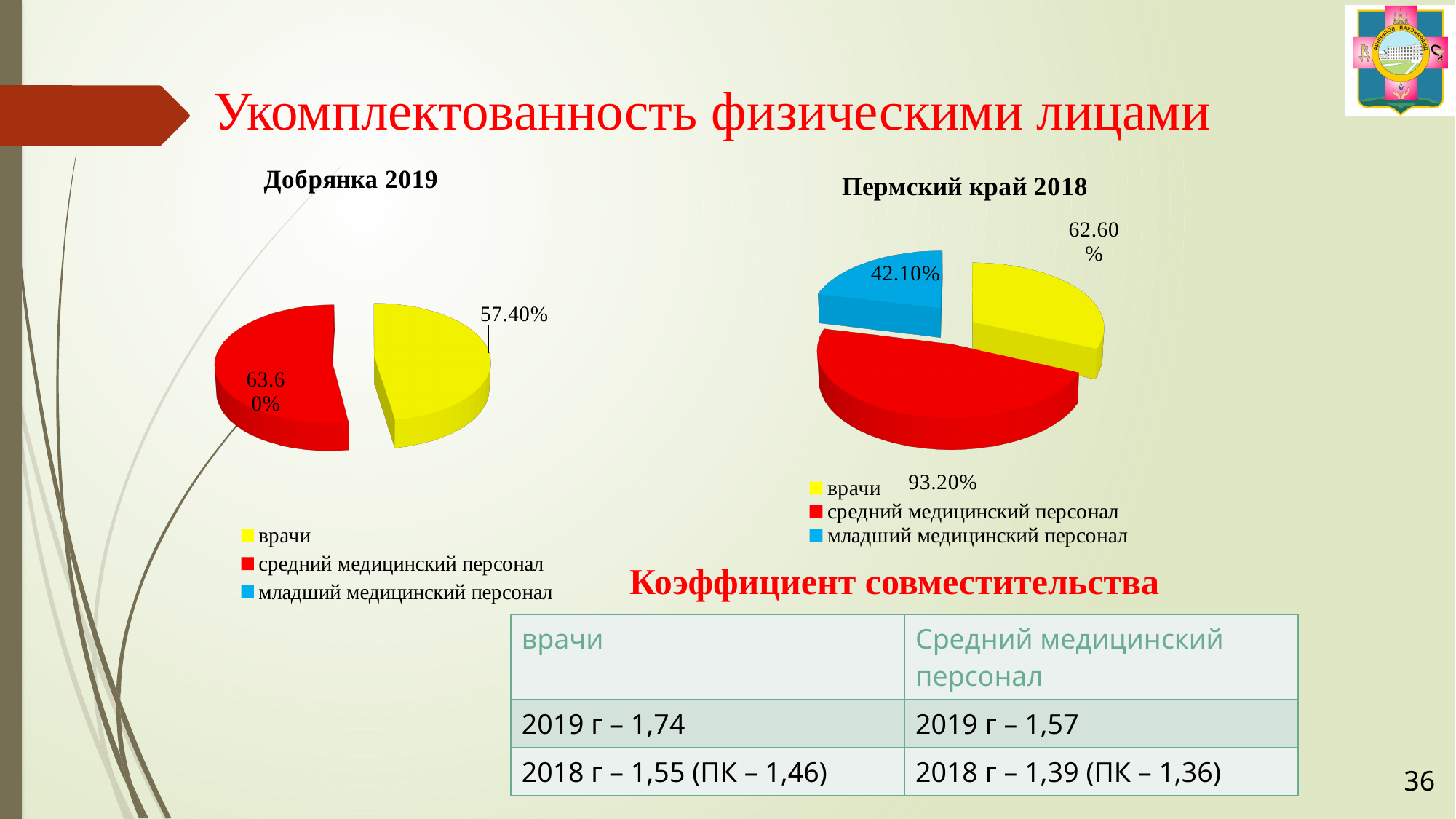
In the 'Пермский край 2018' chart, what is the value for врачи? 62.60% What is the difference between the value for врачи in the 'Пермский край 2018' chart and the value for врачи in the 'Добрянка 2019' chart? 5.20% In the 'Пермский край 2018' chart, what is the difference between средний медицинский персонал and младший медицинский персонал? 51.10% In the 'Добрянка 2019' chart, which is larger: врачи or средний медицинский персонал? средний медицинский персонал In the 'Пермский край 2018' chart, which category has the lowest value? младший медицинский персонал How many entries does the legend of the 'Пермский край 2018' chart list? 3 In the 'Добрянка 2019' chart, what is the value for врачи? 57.40% In the 'Добрянка 2019' chart, what is the value for средний медицинский персонал? 63.60% What type of chart is the 'Добрянка 2019' chart? pie chart In the 'Пермский край 2018' chart, which category has the highest value? средний медицинский персонал In the 'Пермский край 2018' chart, what is the value for средний медицинский персонал? 93.20% In the 'Пермский край 2018' chart, what is the value for младший медицинский персонал? 42.10%